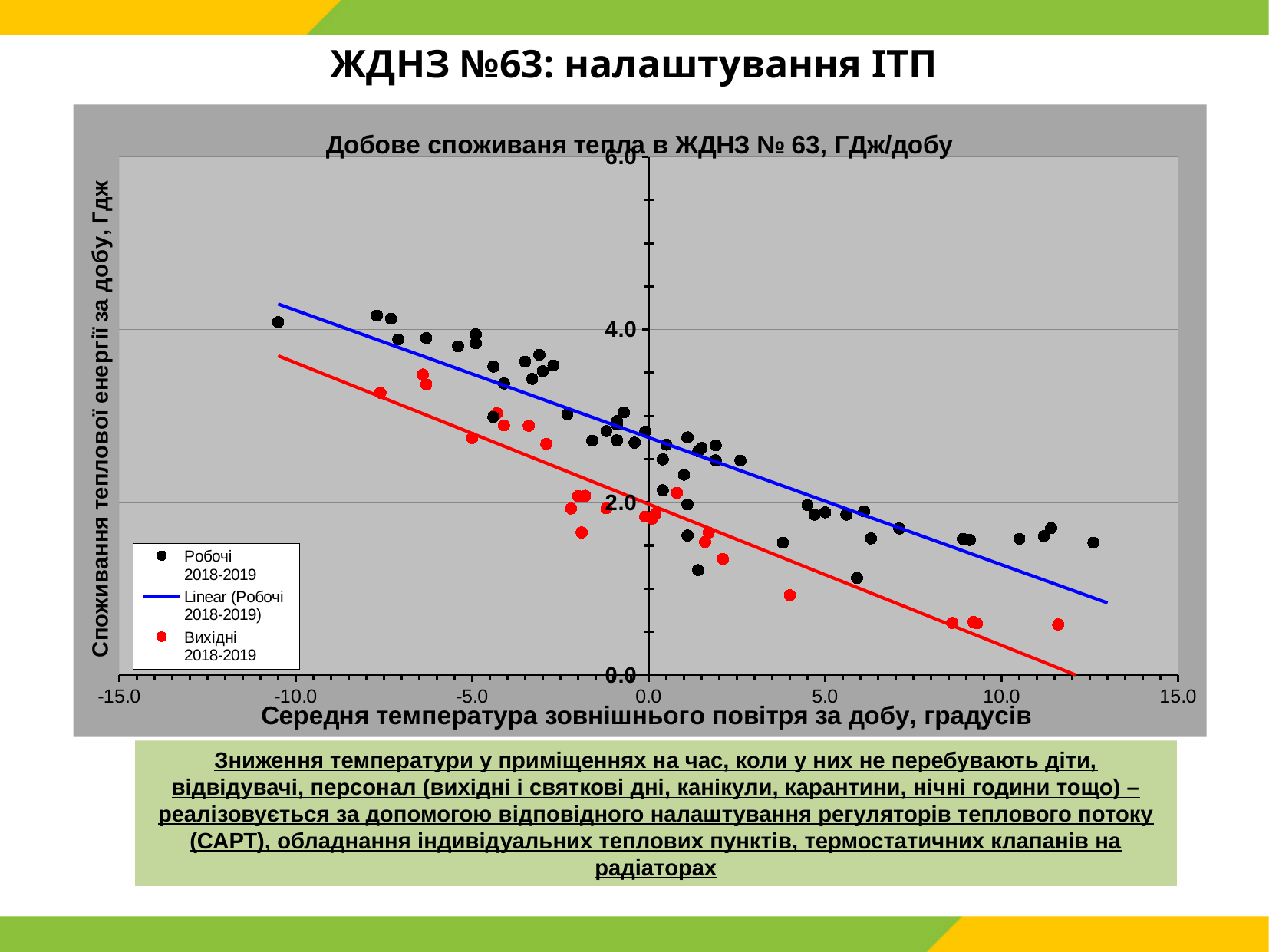
How many entries does the chart legend list? 3 What kind of chart is shown on the slide? scatter chart What is the title of the chart? Добове споживаня тепла в ЖДНЗ № 63, ГДж/добу Is the value for the Вихідні 2018-2019 point near -7.5 degrees greater or less than 4.0? less Is the value for the Вихідні 2018-2019 point near 11.5 degrees greater or less than 2.0? less What is the label of the x axis? Середня температура зовнішнього повітря за добу, градусів Is the value for the Вихідні 2018-2019 point near 4.0 degrees greater or less than 2.0? less Which series lies higher on the chart overall, Робочі 2018-2019 or Вихідні 2018-2019? Робочі 2018-2019 What is the maximum value shown on the y axis? 6.0 Do the plotted values rise or fall as the outdoor temperature increases along the x axis? fall